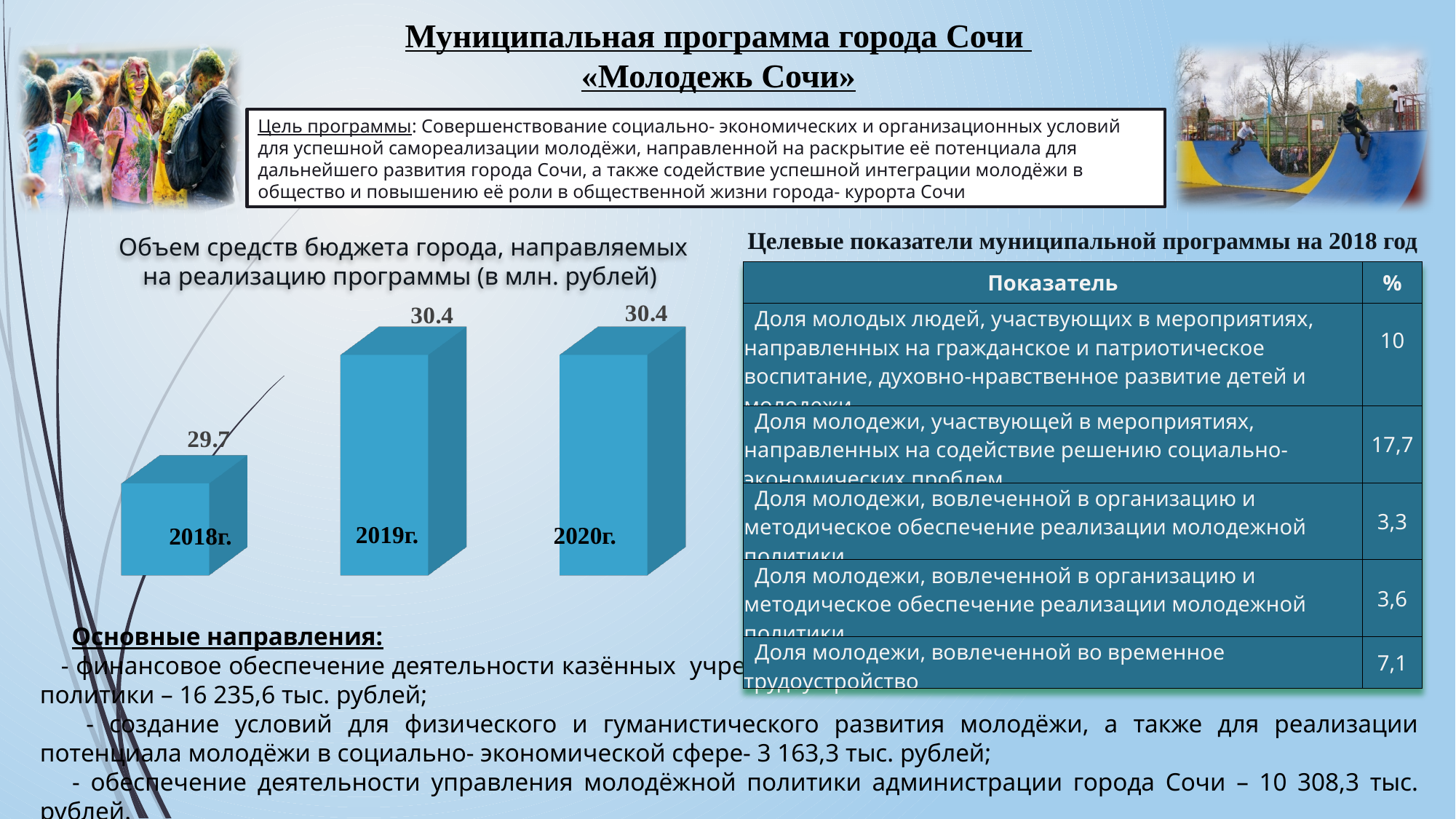
What is the difference between the values for 2019г. and 2018г. in the bar chart? 0.7 What kind of chart is used to show the budget funds by year? Bar chart Which year has the lowest value in the bar chart? 2018г. Which is larger in the bar chart: the value for 2018г. or the value for 2019г.? 2019г. What is the title of the bar chart on the slide? Объем средств бюджета города, направляемых на реализацию программы (в млн. рублей) What is the value for 2020г. in the bar chart? 30.4 In what units are the values in the bar chart expressed, according to its title? млн. рублей What is the value for 2018г. in the chart "Объем средств бюджета города, направляемых на реализацию программы"? 29.7 Are the values for 2019г. and 2020г. in the bar chart equal? Yes How many years (categories) are shown in the bar chart? 3 What is the value for 2019г. in the bar chart? 30.4 Do the values in the bar chart rise or fall from 2018г. to 2019г.? Rise